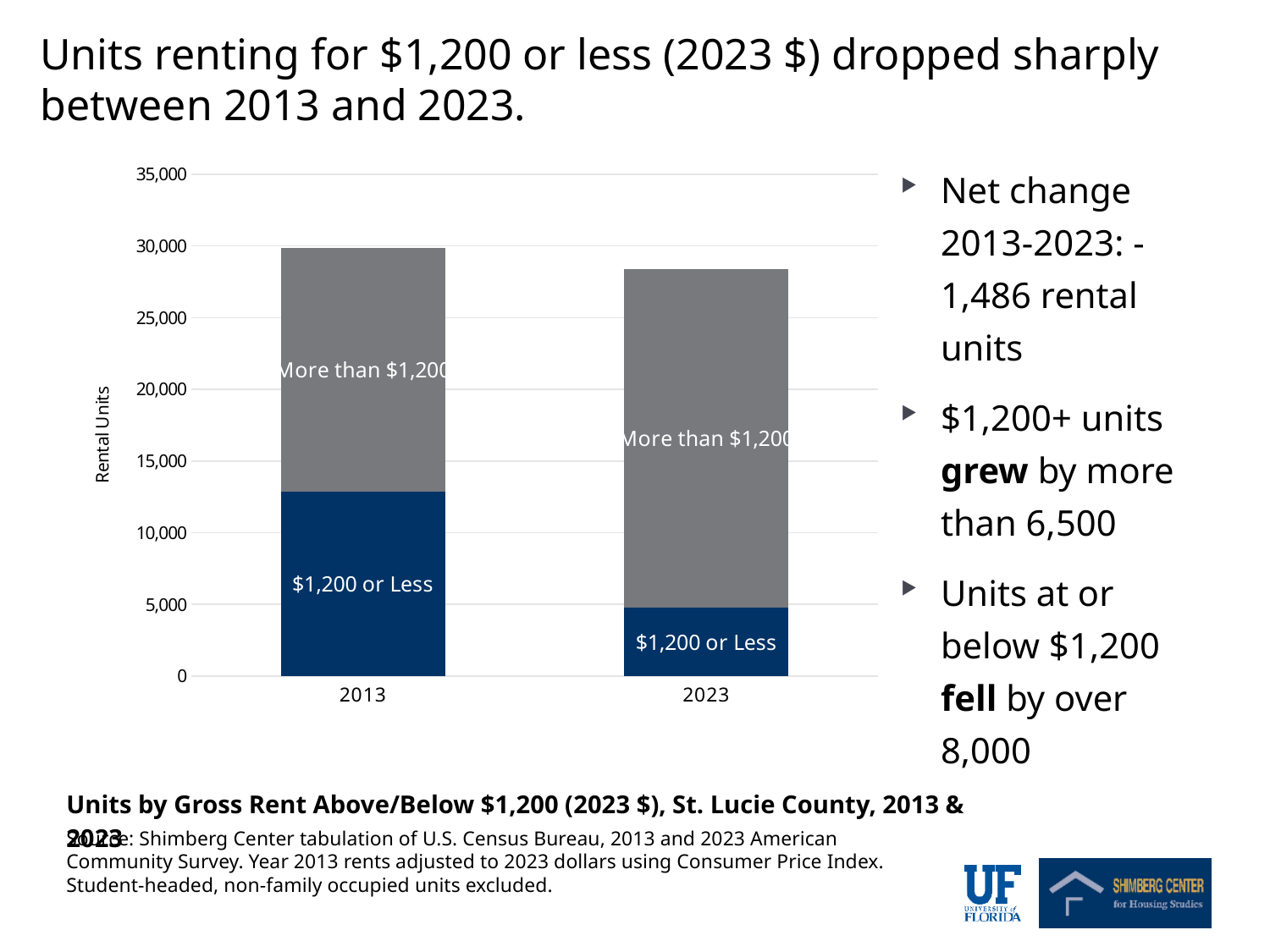
Is the value for $1,200 or Less units in 2013 greater or less than 10,000? greater How many rent series are stacked in each bar of the chart? 2 Which year has the larger number of More than $1,200 rental units, 2013 or 2023? 2023 What is the label of the vertical axis of the chart? Rental Units Is the total height of the 2023 bar greater or less than 30,000? less Which series is shown in dark blue at the bottom of each bar? $1,200 or Less Which year has the larger number of $1,200 or Less rental units, 2013 or 2023? 2013 Is the total height of the 2013 bar greater or less than 25,000? greater Does the number of $1,200 or Less rental units rise or fall from 2013 to 2023? Fall What kind of chart is shown on the slide? Stacked bar chart How many years (categories) are shown on the x axis of the chart? 2